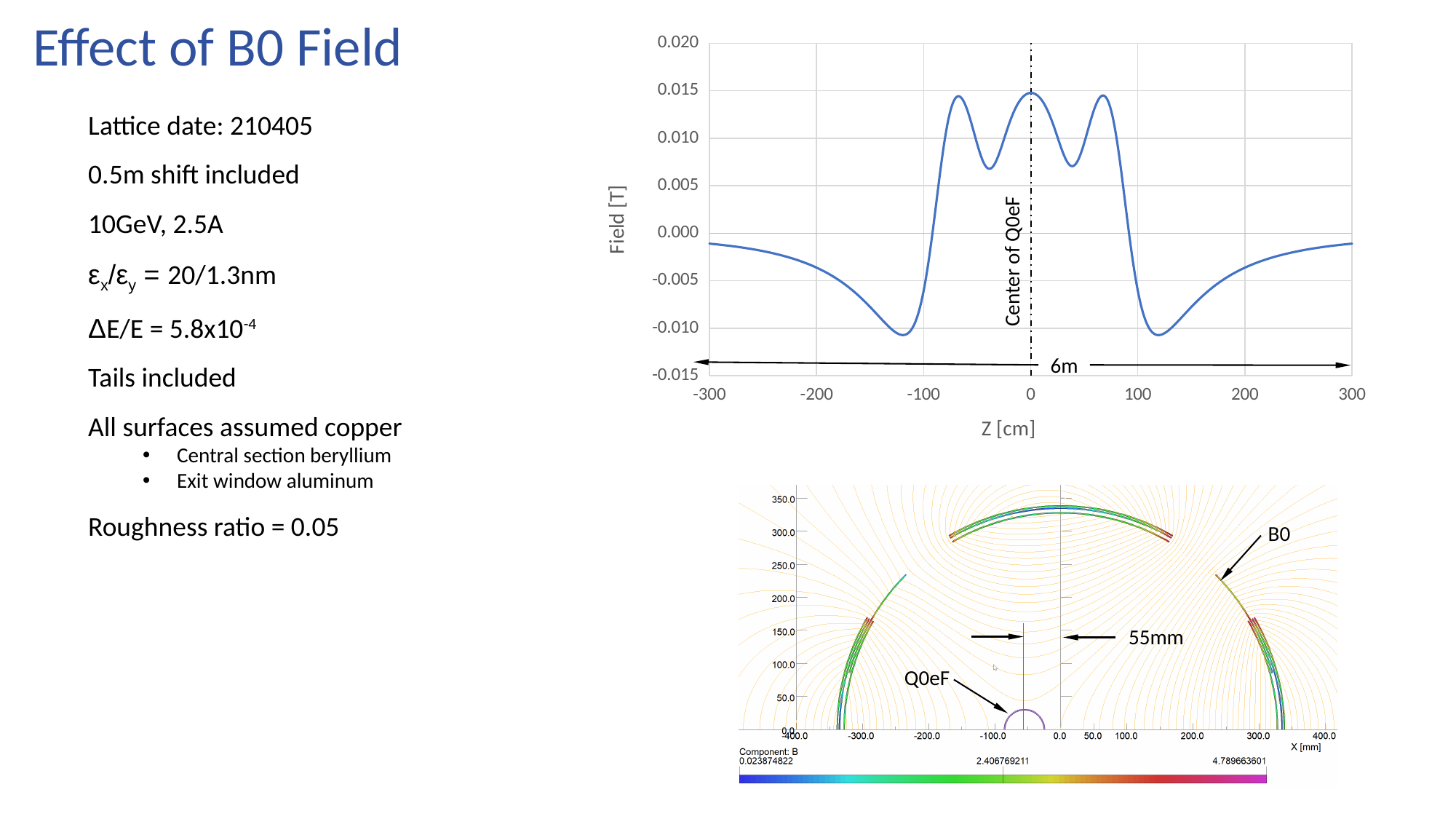
In the top-right Field vs Z chart, is the field value at Z = 200 cm greater or less than 0.000 T? less In the top-right Field vs Z chart, is the field value at Z = 0 cm greater or less than 0.010 T? greater In the top-right Field vs Z chart, what is the label on the vertical dash-dot line at Z = 0? Center of Q0eF In the top-right Field vs Z chart, is the field value at Z = 70 cm greater or less than 0.010 T? greater What kind of chart is the top-right chart of Field [T] versus Z [cm]? line chart In the bottom-right field map, what is the maximum value printed on the Component: B colour scale? 4.789663601 In the top-right Field vs Z chart, which is larger: the field at Z = 0 cm or the field at Z = 120 cm? Z = 0 cm In the top-right Field vs Z chart, does the field rise or fall as Z goes from -300 cm to -120 cm? fall In the bottom-right field map, what is the label on the horizontal axis? X [mm] In the top-right Field vs Z chart, does the field rise or fall as Z goes from 120 cm to 300 cm? rise